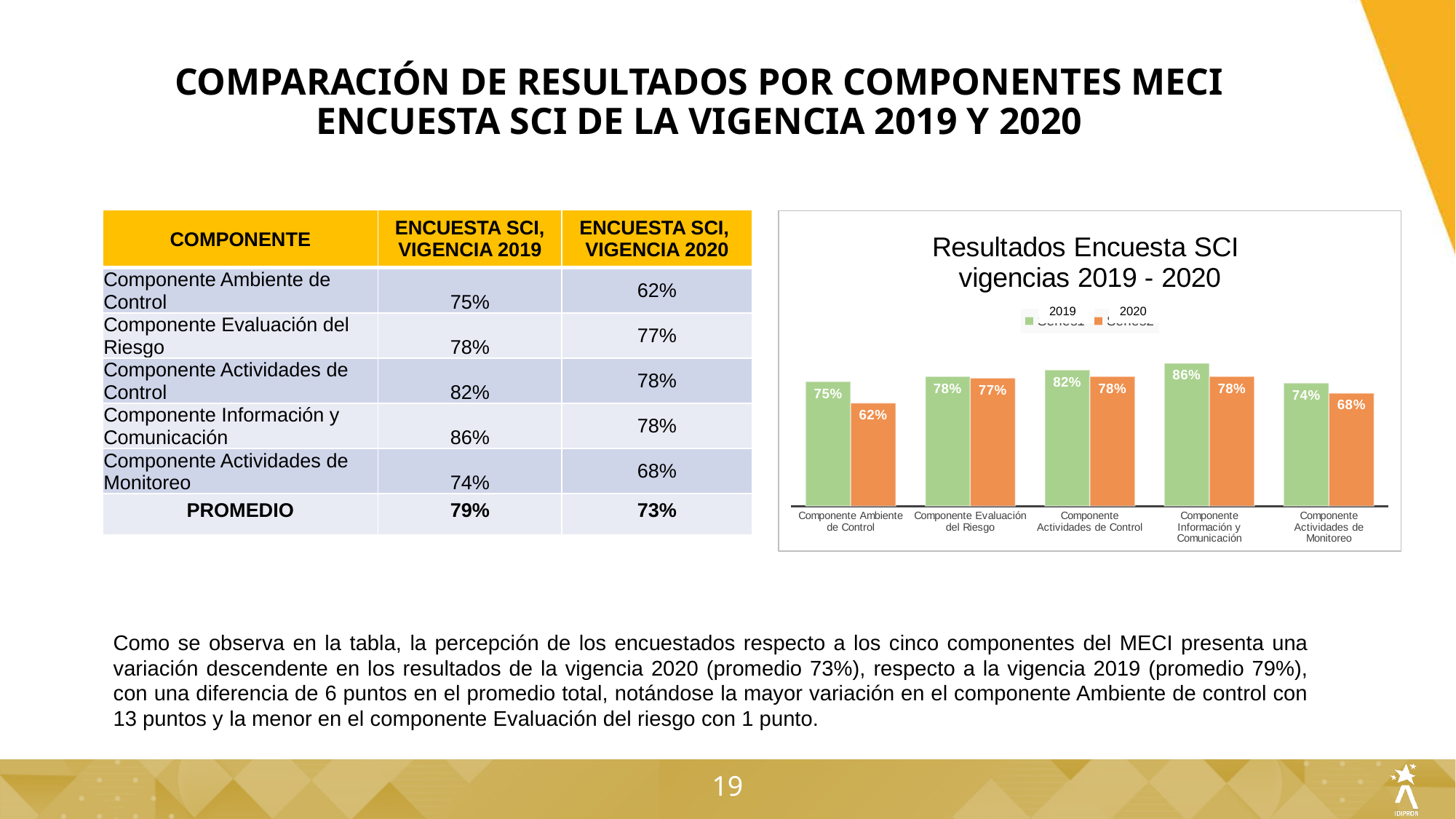
What is the difference between the 2019 and 2020 values for Componente Información y Comunicación? 8% How many categories are shown on the x axis of the chart? 5 What type of chart is shown on the slide? bar chart What is the title of the chart? Resultados Encuesta SCI vigencias 2019 - 2020 What is the 2020 value for Componente Actividades de Monitoreo? 68% What is the difference between the 2019 and 2020 values for Componente Ambiente de Control? 13% Which is larger for Componente Actividades de Control, the 2019 value or the 2020 value? 2019 What is the 2020 value for Componente Evaluación del Riesgo? 77% How many series does the chart's legend list? 2 Which category has the highest 2019 value? Componente Información y Comunicación Which category has the lowest 2020 value? Componente Ambiente de Control What is the 2019 value for Componente Ambiente de Control? 75%